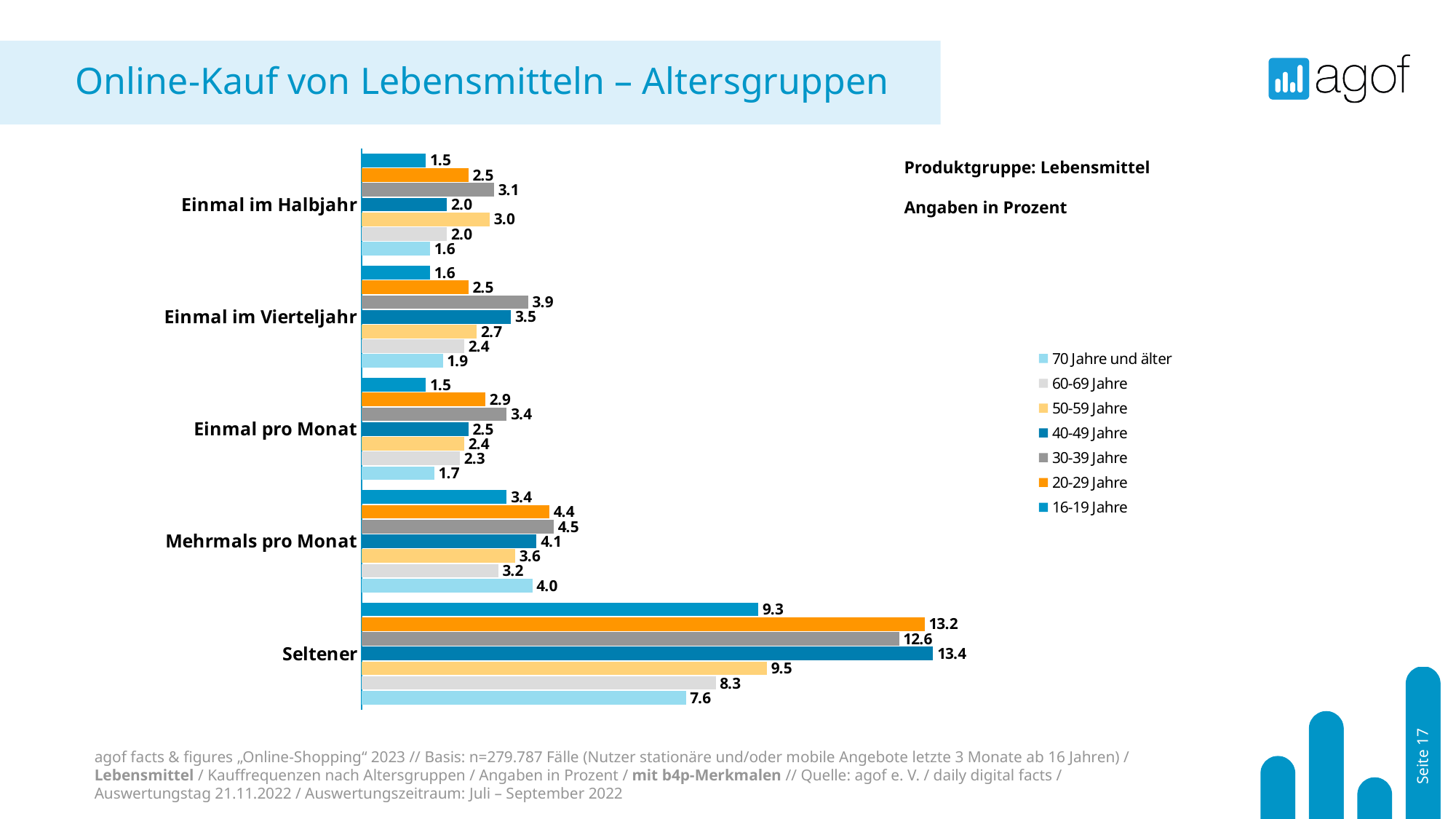
How many purchase-frequency categories are shown on the chart? 5 How many age groups does the legend list? 7 What is the value for 30-39 Jahre in the Einmal im Vierteljahr category? 3.9 Which age group has the lowest value in the Seltener category? 70 Jahre und älter Which age group is shown in orange in the legend? 20-29 Jahre Which is larger in the Einmal pro Monat category: the value for 20-29 Jahre or the value for 40-49 Jahre? 20-29 Jahre What kind of chart is shown on the slide? Bar chart What is the difference between the 30-39 Jahre and 16-19 Jahre values in the Einmal im Halbjahr category? 1.6 What is the value for 70 Jahre und älter in the Mehrmals pro Monat category? 4.0 Which age group has the highest value in the Seltener category? 40-49 Jahre What is the difference between the 20-29 Jahre and 60-69 Jahre values in the Seltener category? 4.9 What is the value for 40-49 Jahre in the Seltener category? 13.4